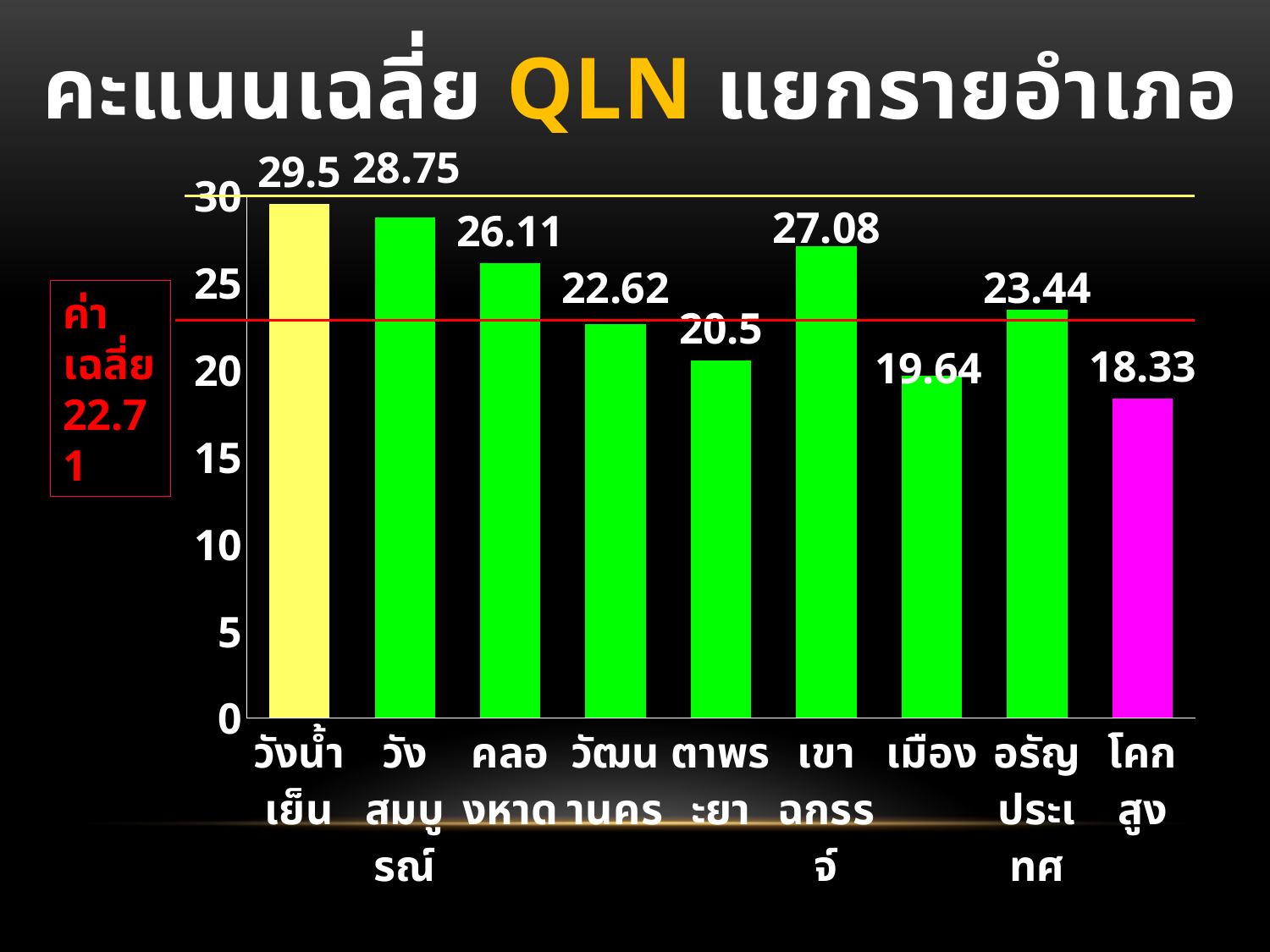
Which has a higher average QLN score, คลองหาด or เขาฉกรรจ์? เขาฉกรรจ์ Which district has the highest average QLN score? วังน้ำเย็น Which district has the lowest average QLN score? โคกสูง What is the average QLN score for อรัญประเทศ? 23.44 What is the difference between the scores of วังน้ำเย็น and โคกสูง? 11.17 What overall average value (ค่าเฉลี่ย) is shown in the red box on the slide? 22.71 What is the average QLN score for วังน้ำเย็น? 29.5 What is the average QLN score for เขาฉกรรจ์? 27.08 How many districts are shown in the chart? 9 What kind of chart is shown on the slide? Bar chart What colour is the bar for โคกสูง? Magenta What is the average QLN score for โคกสูง? 18.33